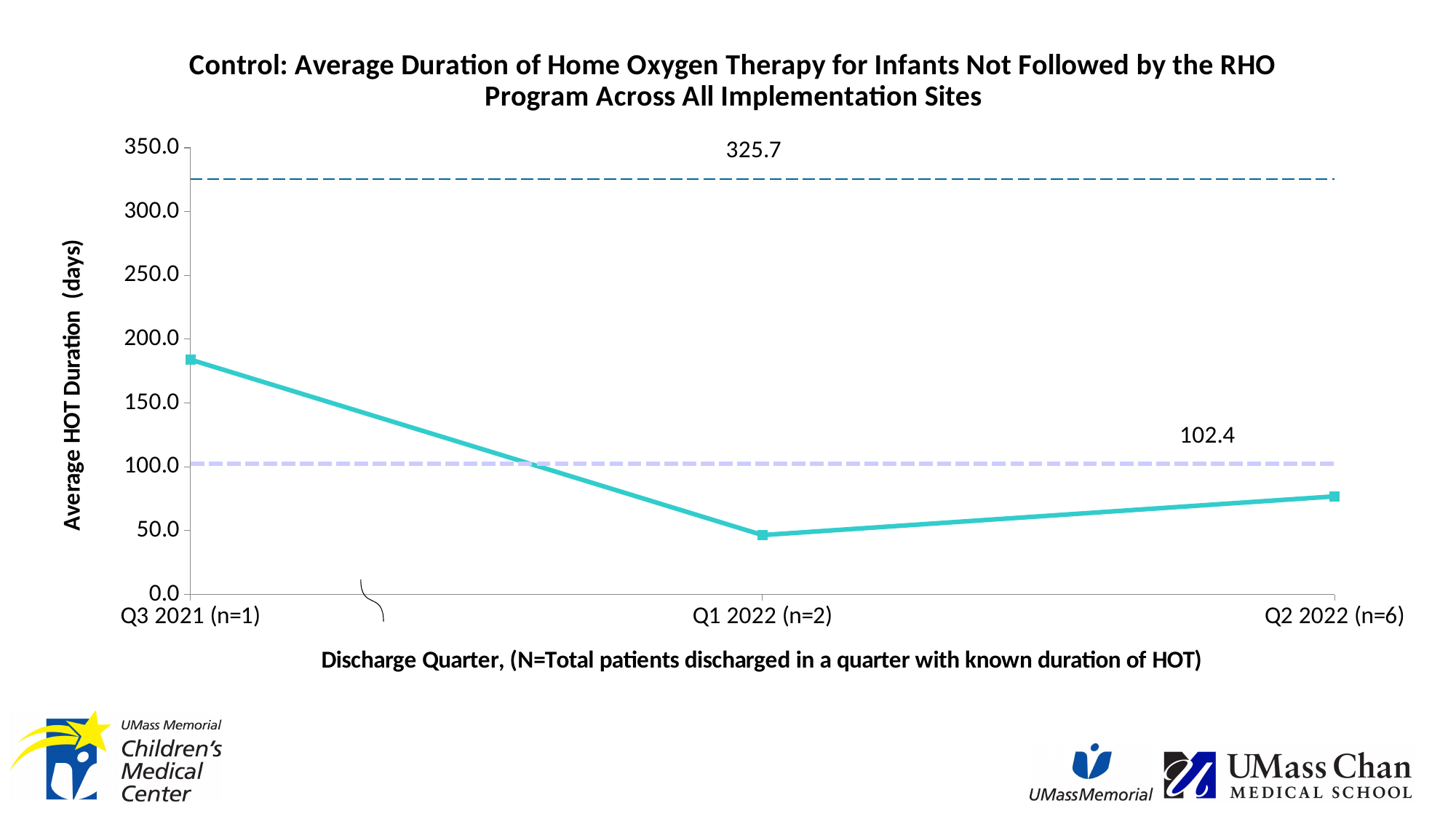
Which discharge quarter has the highest average HOT duration? Q3 2021 (n=1) What value is labelled on the upper dashed reference line? 325.7 Which has a larger average HOT duration, Q3 2021 (n=1) or Q2 2022 (n=6)? Q3 2021 (n=1) What value is labelled on the lower dashed reference line? 102.4 How many discharge quarters are plotted on the x axis? 3 What kind of chart is shown on the slide? line chart Does the average HOT duration rise or fall from Q3 2021 to Q1 2022? fall Is the average HOT duration for Q2 2022 (n=6) greater or less than 100.0 days? less What is the label of the y axis? Average HOT Duration (days) Is the average HOT duration for Q3 2021 (n=1) greater or less than 150.0 days? greater Which discharge quarter has the lowest average HOT duration? Q1 2022 (n=2)